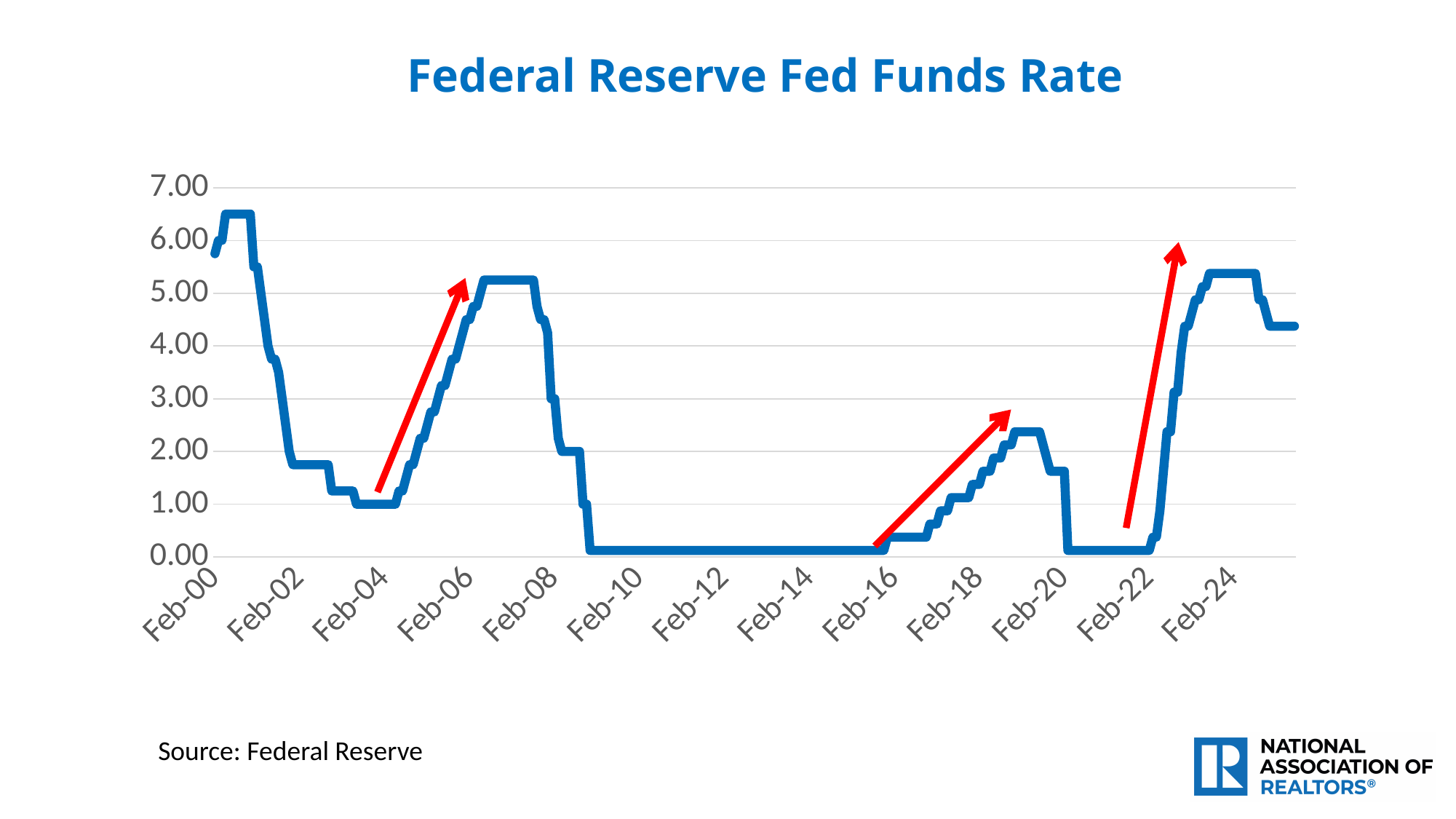
Does the line rise or fall between Feb-22 and Feb-24? rise Is the value at Feb-00 greater or less than 5.00? greater Is the value at Feb-24 greater or less than 5.00? greater What source is cited for the chart? Federal Reserve Is the value at Feb-12 greater or less than 1.00? less How many labels are shown on the x axis? 13 What is the title of the chart? Federal Reserve Fed Funds Rate Does the line rise or fall between Feb-08 and Feb-10? fall What kind of chart is shown on the slide? line chart